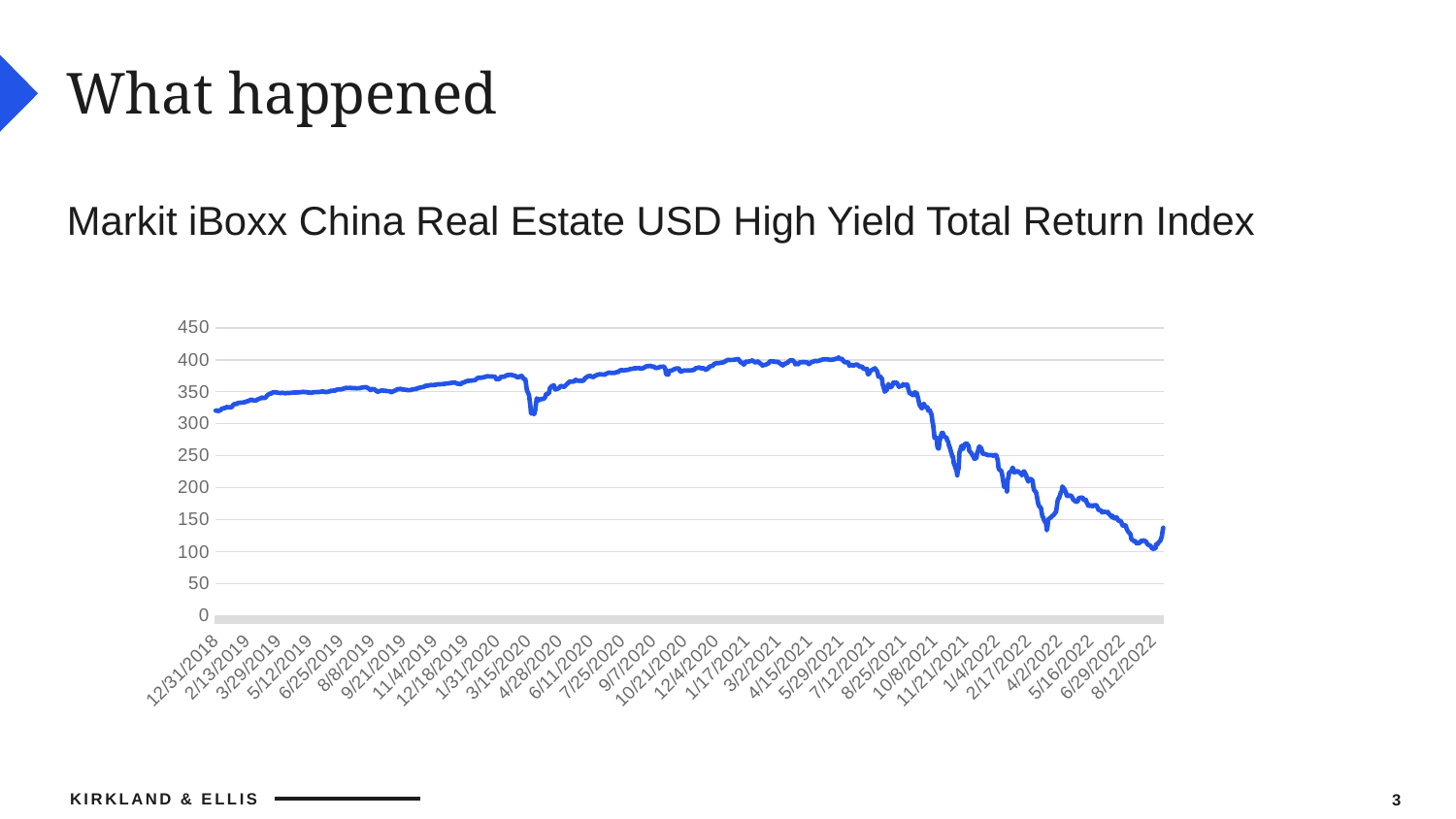
Does the index rise or fall between 12/31/2018 and 5/29/2021? rise Is the value at 5/29/2021 greater or less than 350? greater How many lines are plotted on the chart? 1 Is the value at 8/12/2022 greater or less than 200? less Is the value at 1/17/2021 greater or less than 350? greater What is the highest value shown on the y axis? 450 Does the index rise or fall between 7/12/2021 and 8/12/2022? fall What kind of chart is shown on the slide? line chart Does the index rise or fall overall between 12/31/2018 and 8/12/2022? fall What is the title of the chart on the slide? Markit iBoxx China Real Estate USD High Yield Total Return Index